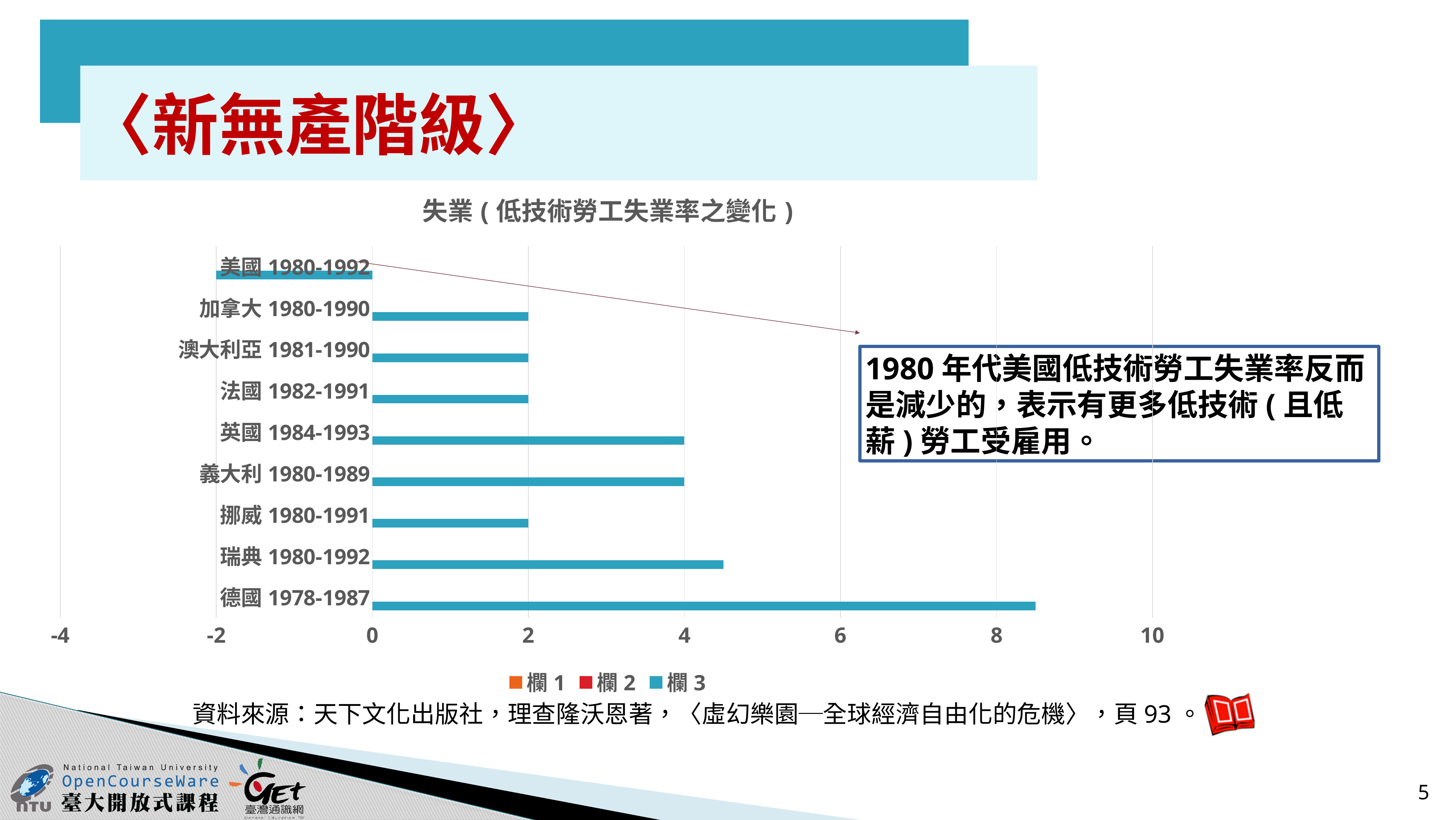
What is the value for 英國 1984-1993? 4 What kind of chart is shown on the slide? bar chart Is the value for 德國 1978-1987 greater or less than 8? greater Which category has the highest value in the chart? 德國 1978-1987 What is the difference between the values for 義大利 1980-1989 and 法國 1982-1991? 2 How many series does the legend list? 3 How many categories (country-period bars) does the chart show? 9 What is the value for 美國 1980-1992? -2 Which category has the lowest value in the chart? 美國 1980-1992 Which has the larger value, 英國 1984-1993 or 挪威 1980-1991? 英國 1984-1993 Is the value for 瑞典 1980-1992 greater or less than 4? greater What is the value for 加拿大 1980-1990? 2